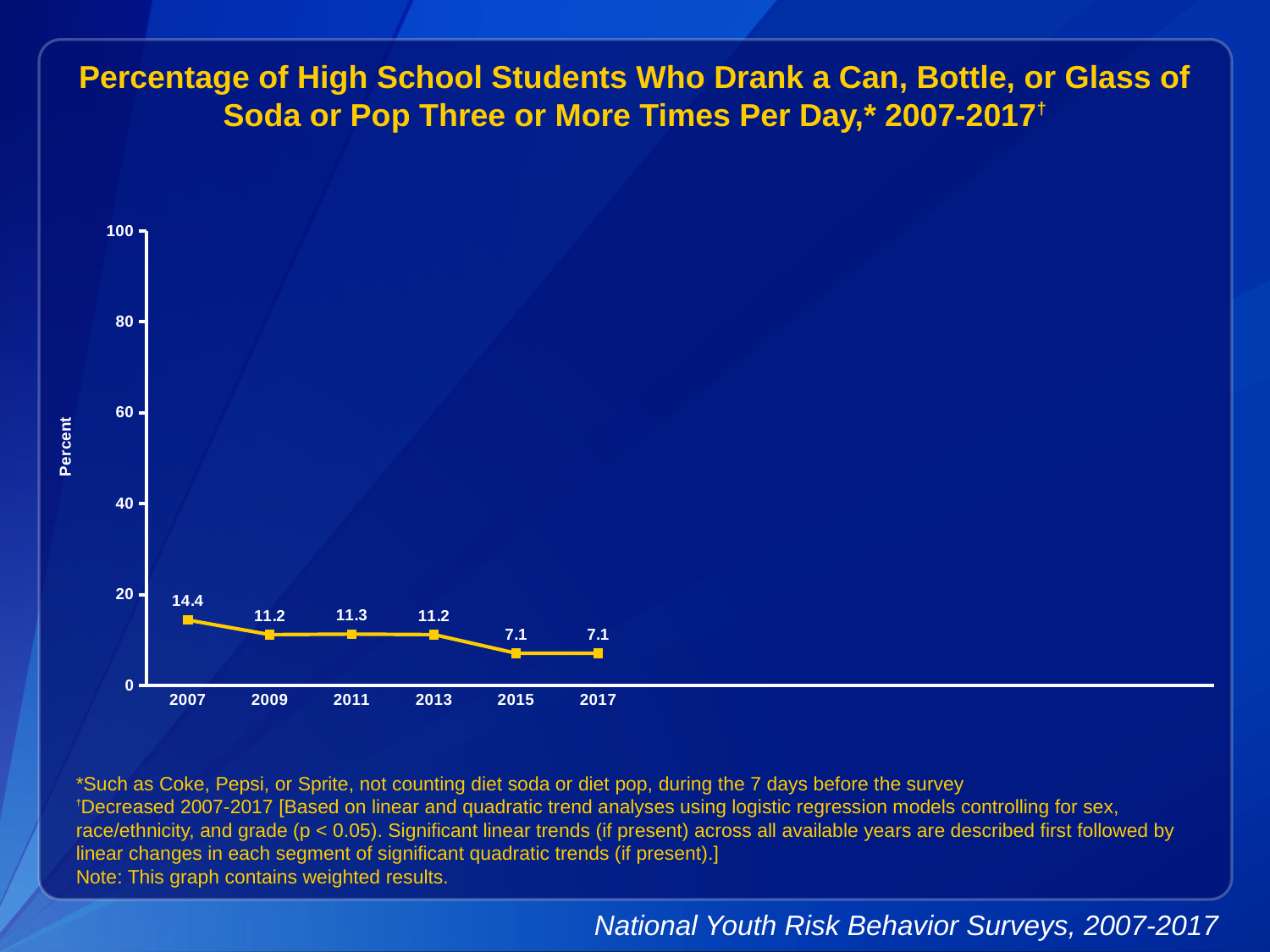
What is the difference between the 2013 value and the 2015 value? 4.1 What was the percentage of high school students who drank soda or pop three or more times per day in 2007? 14.4 Do the values generally rise or fall from 2007 to 2017? fall What kind of chart is shown on the slide? line chart Which year has the highest value on the chart? 2007 What value is plotted for 2017? 7.1 What is the label on the vertical axis? Percent What is the difference between the 2007 value and the 2017 value? 7.3 How many years are plotted on the chart? 6 What value is plotted for 2011? 11.3 Which is larger, the value for 2009 or the value for 2015? 2009 Is the value for 2007 greater or less than 20? less